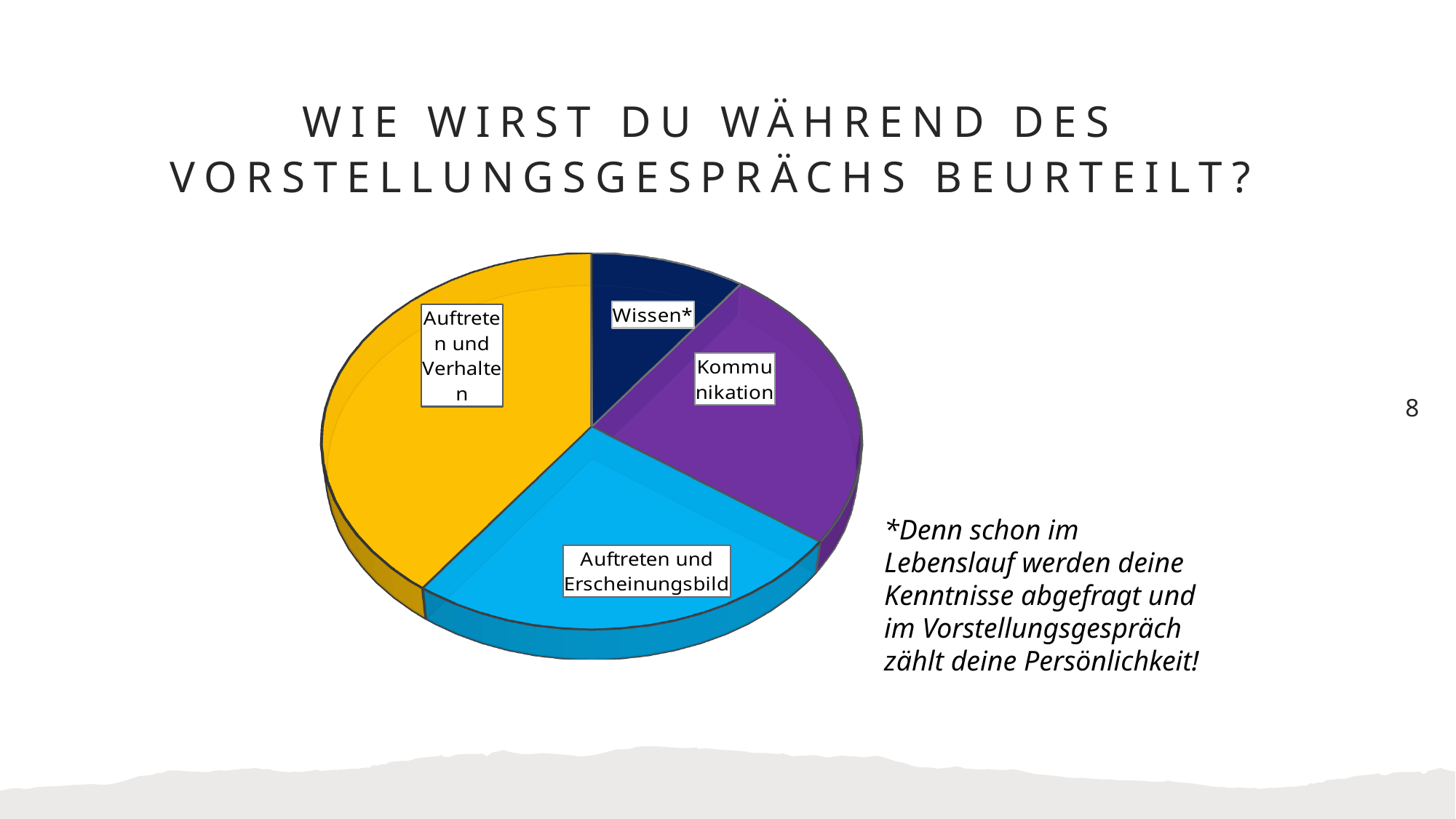
How many slices does the pie chart have? 4 Which slice of the pie chart is the largest? Auftreten und Verhalten What kind of chart is shown on the slide? pie chart Which slice of the pie chart is the smallest? Wissen* Which slice is larger, Auftreten und Verhalten or Wissen*? Auftreten und Verhalten What colour is the Kommunikation slice of the pie chart? purple Which slice is larger, Kommunikation or Wissen*? Kommunikation Which slice of the pie chart is yellow? Auftreten und Verhalten